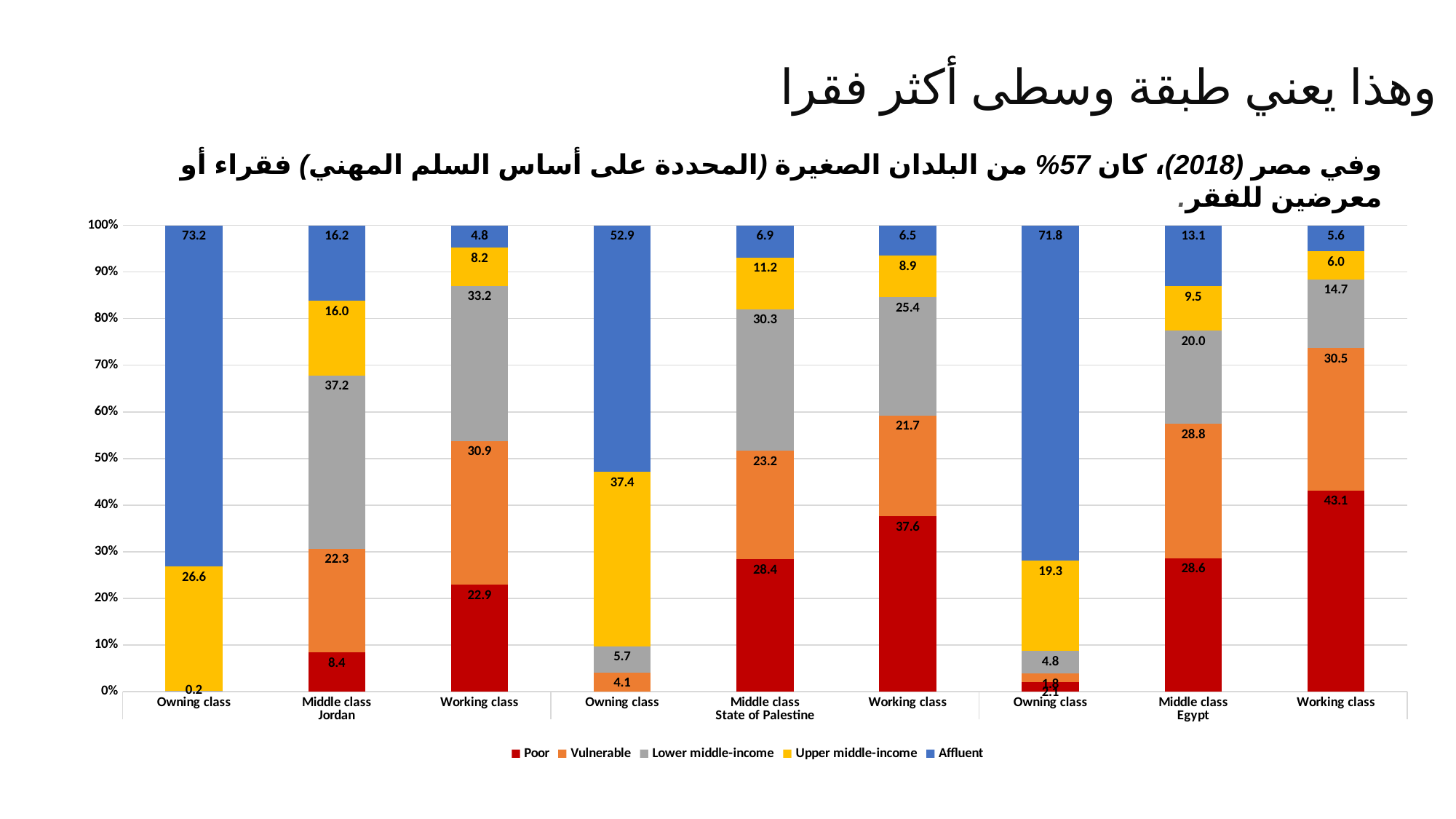
How many series does the legend list? 5 What type of chart is shown on the slide? Stacked bar chart Among the three Egypt classes, which has the highest Poor share? Working class Which is larger: the Vulnerable share of the Middle class in Jordan or the Vulnerable share of the Middle class in Egypt? Middle class in Egypt What colour represents the Poor series in the legend? Dark red What is the difference between the Poor share of the Working class in Egypt and the Poor share of the Working class in Jordan? 20.2 What is the Poor share for the Working class in Egypt? 43.1 What is the Affluent share for the Owning class in Jordan? 73.2 Among the three Jordan classes, which has the lowest Affluent share? Working class What is the Lower middle-income share for the Middle class in the State of Palestine? 30.3 How many bars (class categories) are plotted across all three countries? 9 What is the Upper middle-income share for the Owning class in Egypt? 19.3